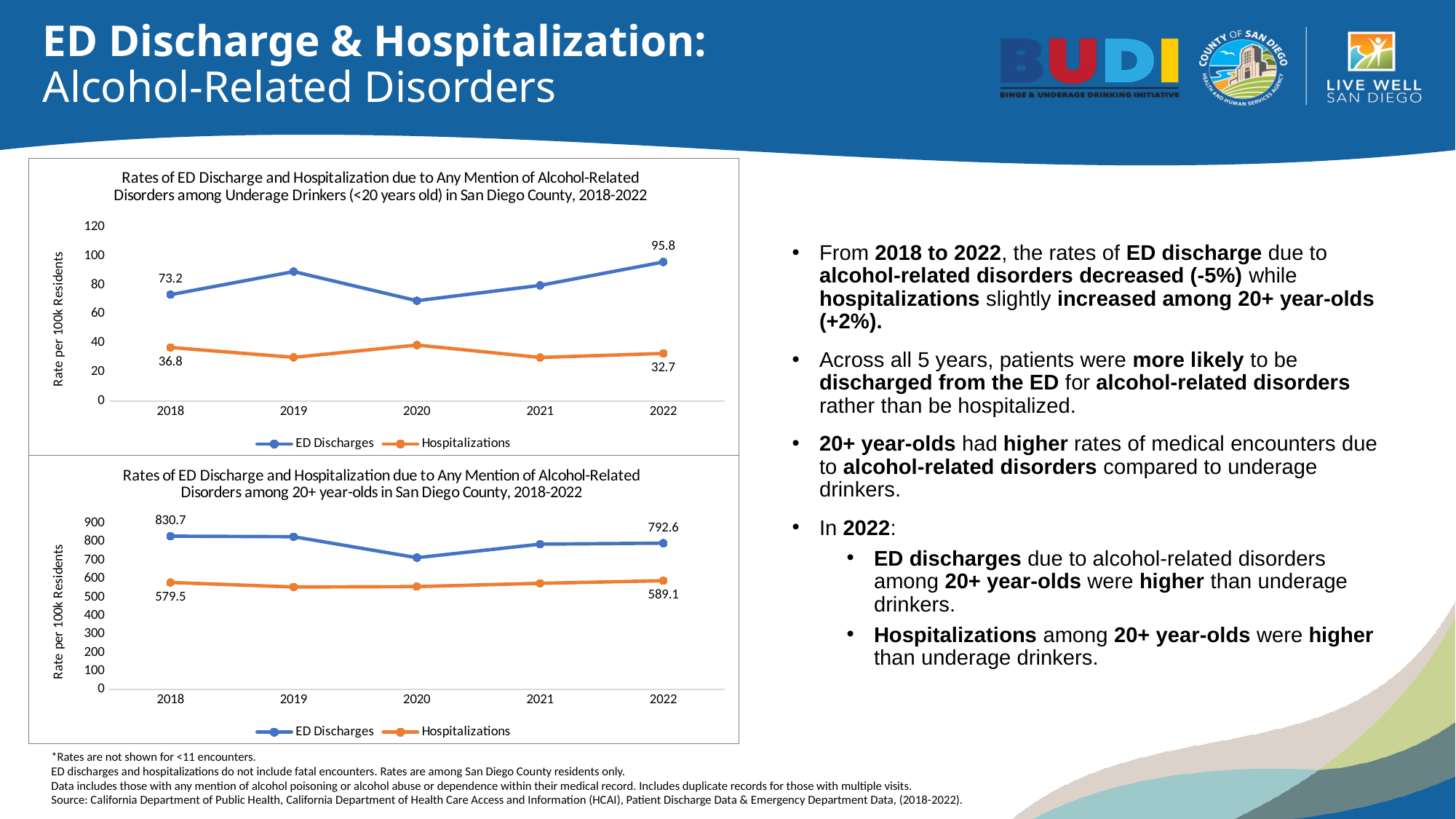
In the bottom chart (20+ year-olds), is the ED discharge rate in 2020 greater or less than 800? less In the bottom chart (20+ year-olds), what is the difference between the ED discharge rate and the hospitalization rate in 2018? 251.2 How many series does the legend of the top chart (underage drinkers) list? 2 In the bottom chart (20+ year-olds), what was the rate of hospitalizations in 2018? 579.5 In the top chart (underage drinkers), what is the difference between the ED discharge rate in 2022 and in 2018? 22.6 In the top chart (underage drinkers), what was the rate of ED discharges in 2018? 73.2 In the bottom chart (20+ year-olds), what was the rate of ED discharges in 2022? 792.6 In the top chart (underage drinkers), what was the rate of hospitalizations in 2022? 32.7 What type of chart is the bottom chart (20+ year-olds)? Line chart In the top chart (underage drinkers), which was higher in 2022: the ED discharge rate or the hospitalization rate? ED discharge rate How many years are plotted on the x axis of the bottom chart (20+ year-olds)? 5 In the top chart (underage drinkers), is the hospitalization rate in 2020 greater or less than 20? greater